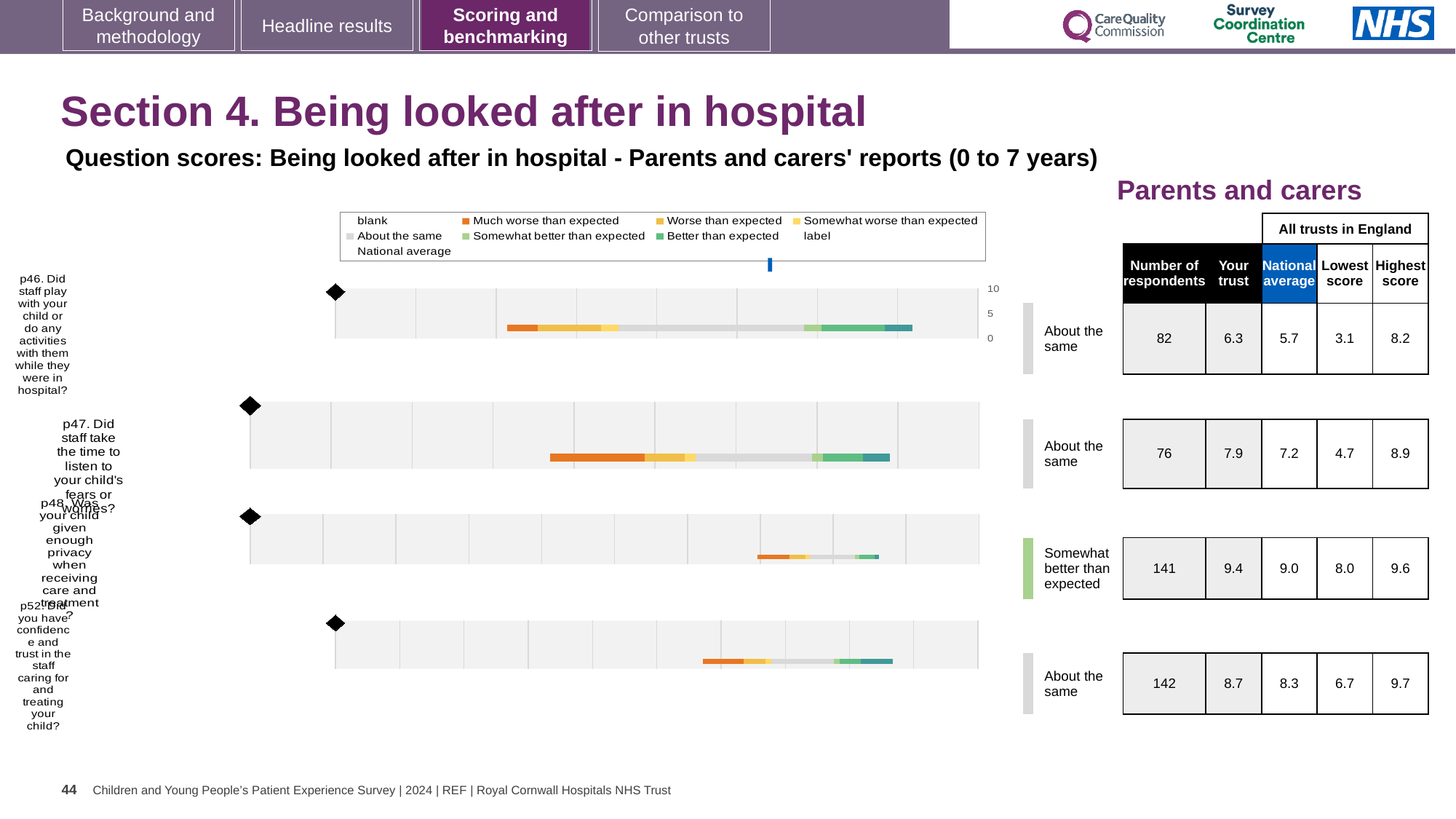
Which question has the highest 'Your trust' score? p48 What kind of chart is used to show the p46 question score? bar chart How many question charts are shown on the slide? 4 How many entries does the chart legend list? 9 For the p52 chart, what is the difference between the 'Your trust' score and the national average? 0.4 What colour represents 'Much worse than expected' in the legend? orange For the p48 chart (Was your child given enough privacy), how many respondents are shown? 141 For the p46 chart (Did staff play with your child), what is the 'Your trust' score shown? 6.3 Which question has the lowest 'Your trust' score? p46 For the p47 chart, which is larger: the 'Your trust' score or the national average? Your trust For the p47 chart (Did staff take the time to listen to your child's fears or worries), what is the national average shown? 7.2 What benchmark category is shown next to the p48 chart? Somewhat better than expected